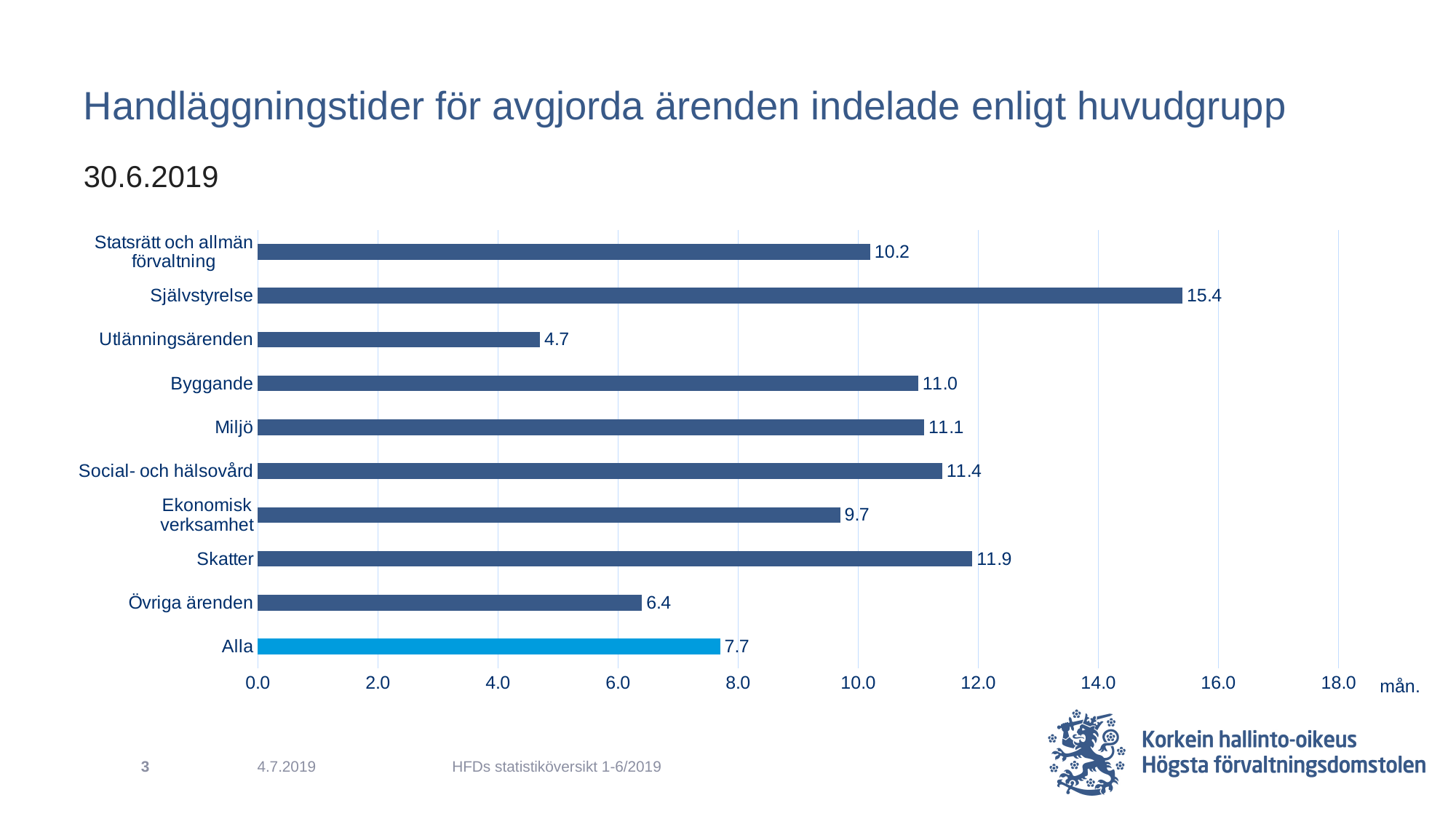
Which category has the highest value? Självstyrelse How many categories are shown in the chart? 10 What is the value for Utlänningsärenden? 4.7 What is the value for Skatter? 11.9 What unit is shown at the end of the x axis? mån. What kind of chart is shown on the slide? bar chart Which is larger, the value for Skatter or the value for Social- och hälsovård? Skatter Which category has the lowest value? Utlänningsärenden What is the difference between the values for Självstyrelse and Utlänningsärenden? 10.7 What is the value for Alla? 7.7 Is the value for Statsrätt och allmän förvaltning greater or less than 10.0? greater What is the value for Självstyrelse? 15.4